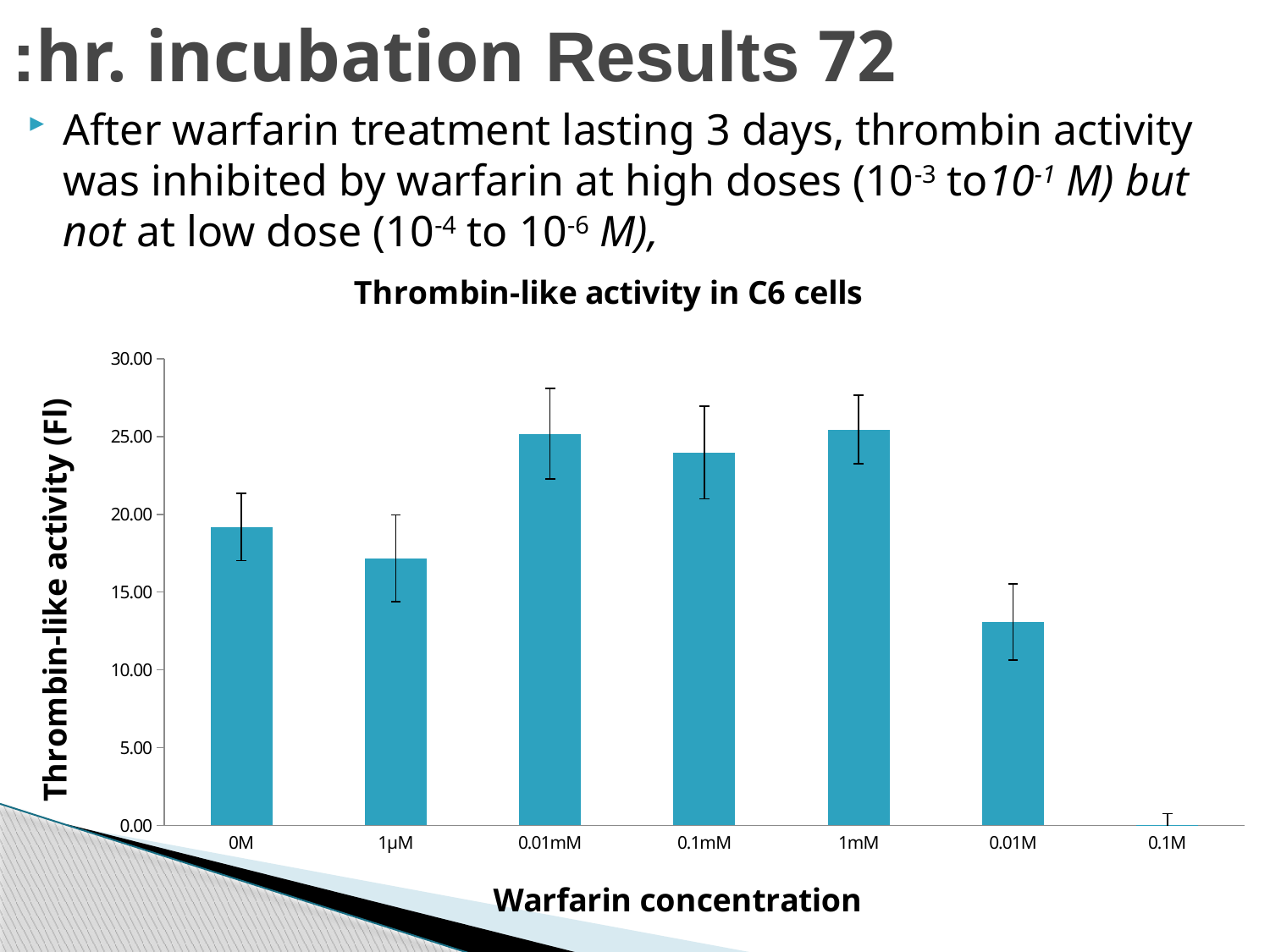
What is the label of the x axis of the chart? Warfarin concentration What type of chart is shown on the slide? bar chart Is the thrombin-like activity for 0.01mM greater or less than 20.00? greater What is the title of the chart? Thrombin-like activity in C6 cells Which warfarin concentration has the lowest thrombin-like activity? 0.1M Is the thrombin-like activity for 0M greater or less than 15.00? greater Is the thrombin-like activity for 1µM greater or less than 20.00? less Which has the higher thrombin-like activity, 0.01mM or 0.01M? 0.01mM How many warfarin concentration categories are shown on the x axis? 7 Which has the higher thrombin-like activity, 0.1mM or 1µM? 0.1mM